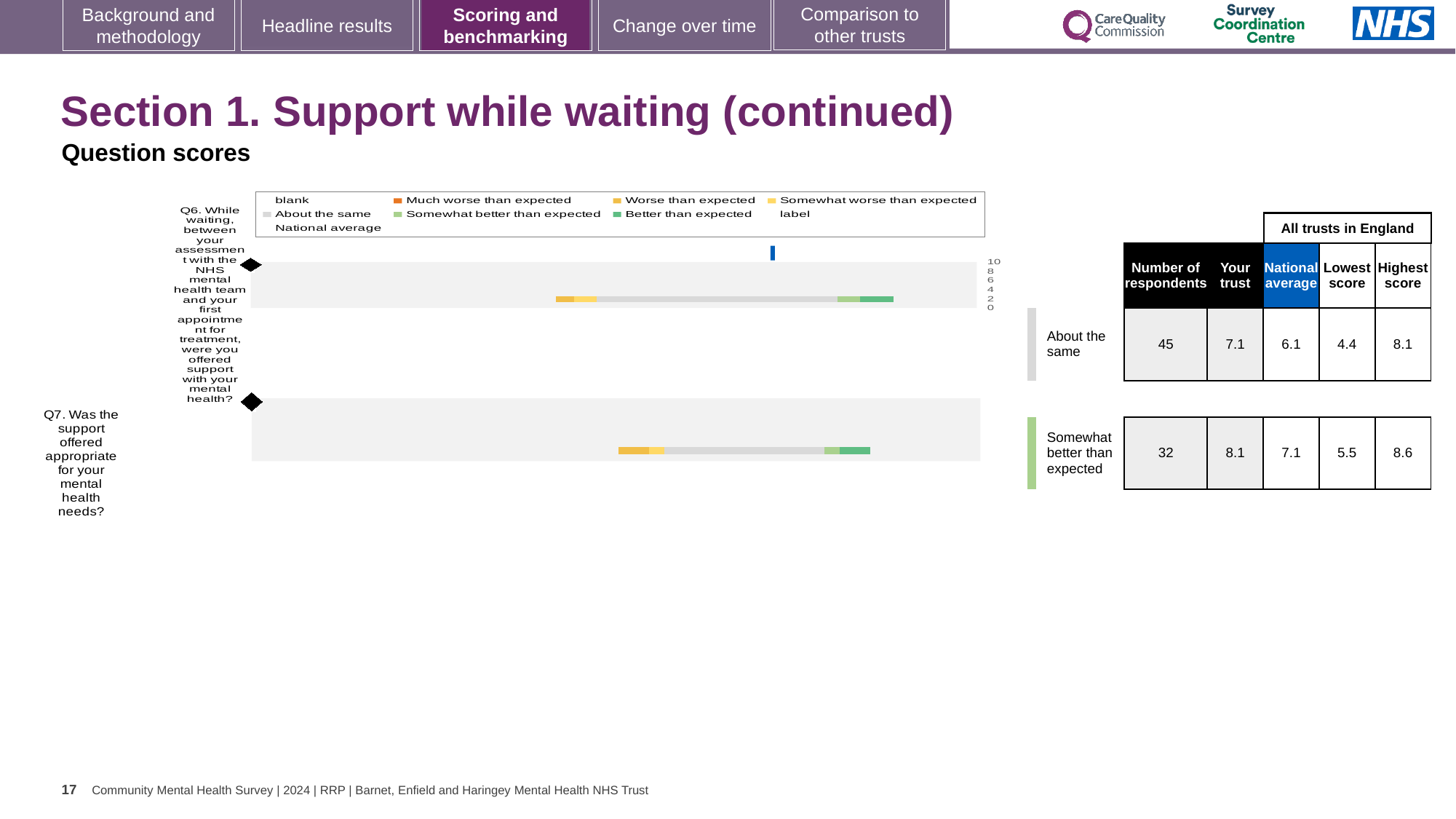
By how much does the 'Your trust' score for Q6 exceed the national average? 1.0 What is the 'Your trust' score for Q7? 8.1 Which question has the higher 'Your trust' score, Q6 or Q7? Q7 How many questions are plotted in the chart? 2 What is the national average score for Q6? 6.1 What benchmark category is Q6 assigned to? About the same What is the lowest score among all trusts in England for Q6? 4.4 What benchmark category is Q7 assigned to? Somewhat better than expected What is the difference between the highest and lowest scores for Q7? 3.1 How many respondents answered Q7? 32 What kind of chart is used to show the question scores on this slide? bar chart What is the 'Your trust' score for Q6? 7.1